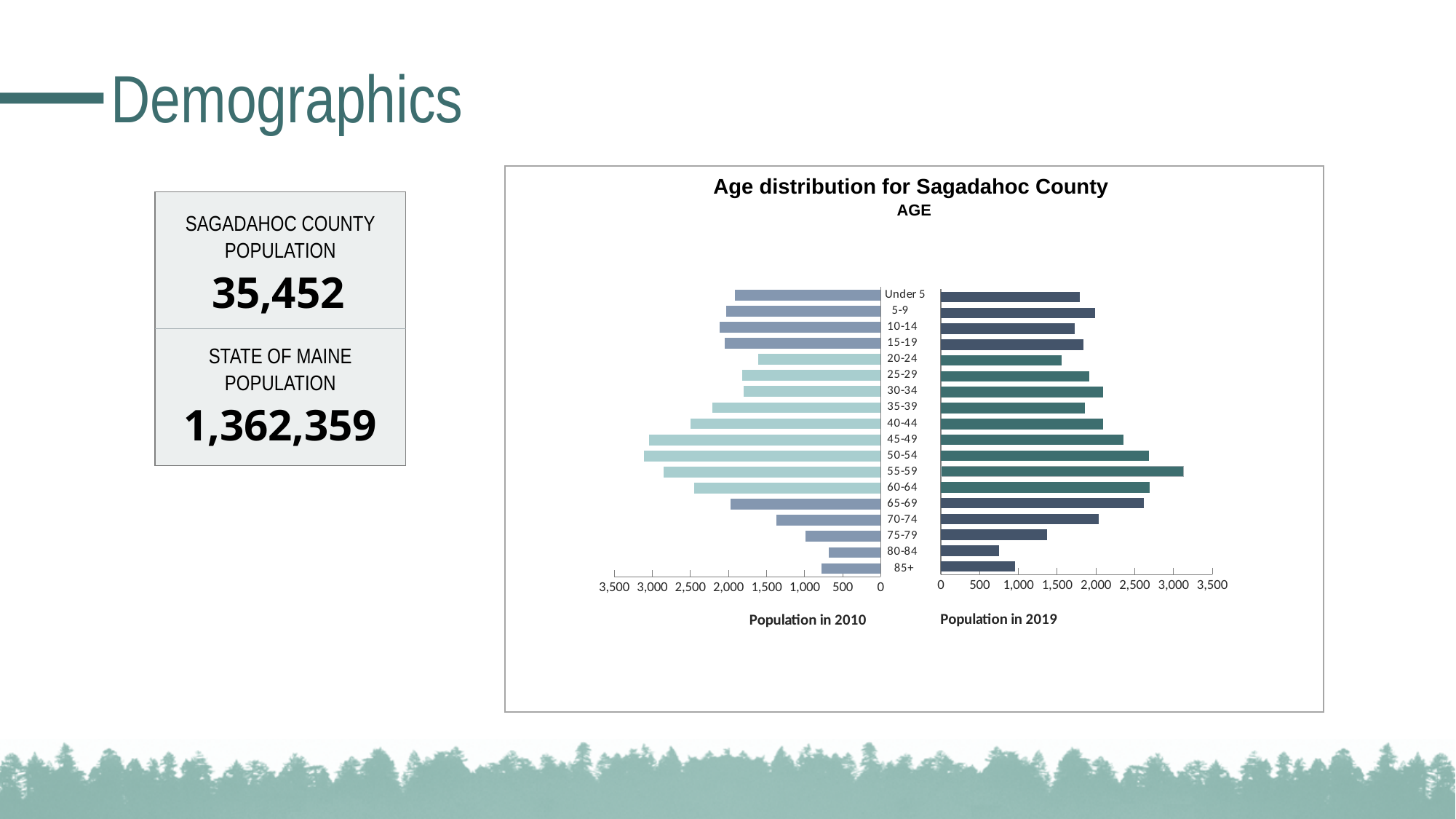
Is the Population in 2019 for the 55-59 age group greater or less than 2,500? greater Is the Population in 2010 for the 20-24 age group greater or less than 2,000? less For the 45-49 age group, which is larger: Population in 2010 or Population in 2019? Population in 2010 Is the Population in 2019 for the 80-84 age group greater or less than 1,000? less What are the two sides of the chart labelled? Population in 2010 and Population in 2019 How many age groups are shown in the Age distribution for Sagadahoc County chart? 18 Which age group has the lowest Population in 2010? 80-84 In the Population in 2019 side, do the values rise or fall from the 55-59 age group to the 80-84 age group? fall Which age group has the highest Population in 2019? 55-59 What kind of chart is shown on the slide? Bar chart What is the title of the chart on the slide? Age distribution for Sagadahoc County Which age group has the lowest Population in 2019? 80-84